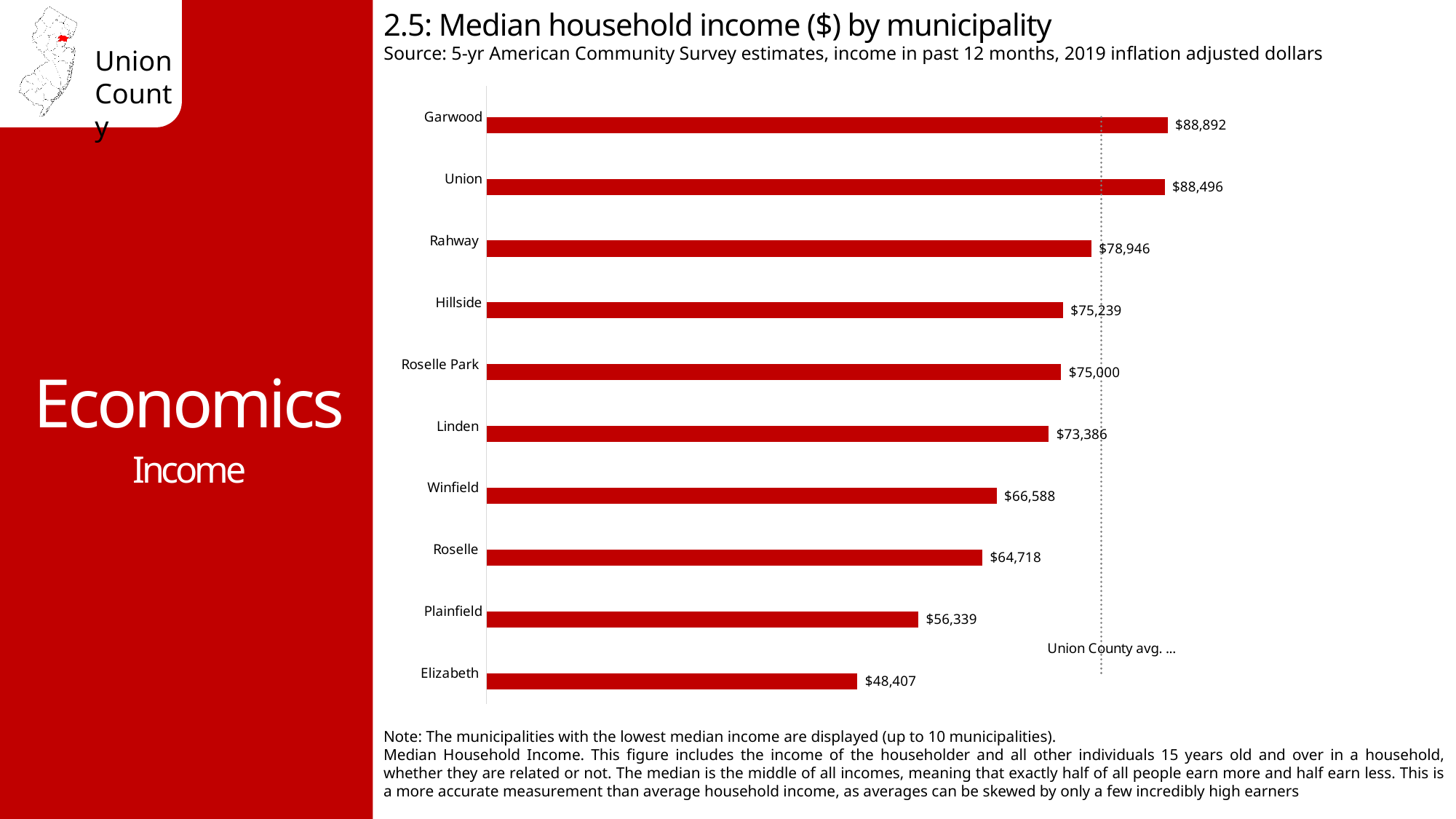
Which municipality has the lowest median household income on the chart? Elizabeth What is the difference between the median household income of Garwood and Elizabeth? $40,485 What is the median household income for Rahway? $78,946 What is the median household income for Elizabeth? $48,407 Which municipality has the highest median household income on the chart? Garwood How many municipalities are shown on the chart? 10 Which has a higher median household income, Plainfield or Roselle? Roselle What is the difference between the median household income of Roselle and Plainfield? $8,379 What is the median household income for Winfield? $66,588 What kind of chart is used to show median household income by municipality? Bar chart What does the dotted vertical line on the chart represent? Union County avg. Which has a higher median household income, Linden or Winfield? Linden